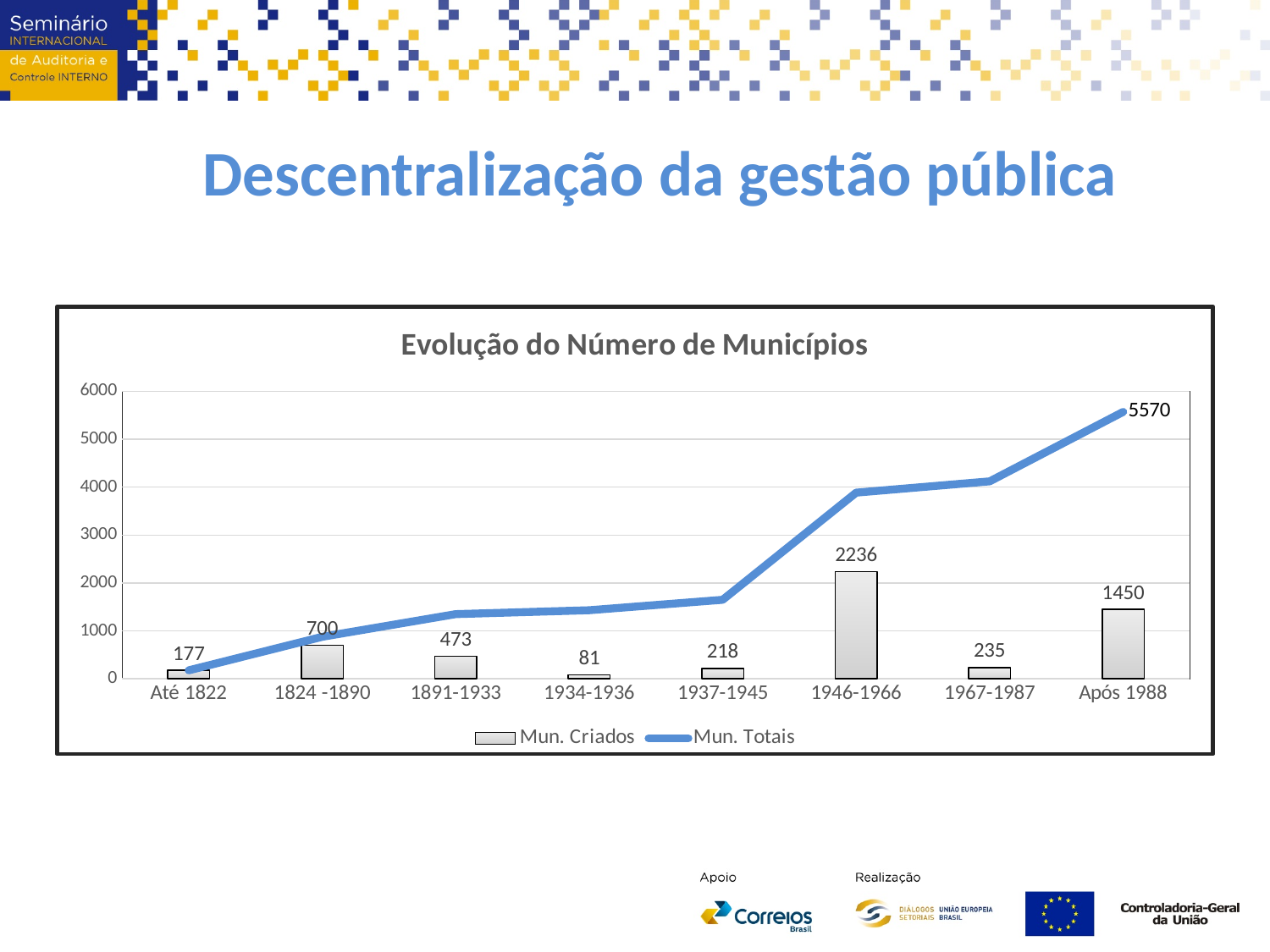
How many series does the chart legend list? 2 What is the value of Mun. Criados for the period Após 1988? 1450 Does the Mun. Totais line rise or fall across the periods from Até 1822 to Após 1988? Rises What is the difference between Mun. Criados in 1946-1966 and in Após 1988? 786 Which period has more Mun. Criados, 1824 -1890 or 1891-1933? 1824 -1890 Is the value of Mun. Totais for 1946-1966 greater or less than 3000? greater Which period has the lowest number of Mun. Criados? 1934-1936 How many periods are shown on the x axis of the chart? 8 What is the value of Mun. Totais shown at Após 1988? 5570 What kind of chart is shown on the slide? Combined bar and line chart How many municipalities were created (Mun. Criados) in the period 1946-1966? 2236 Which period has the highest number of Mun. Criados? 1946-1966